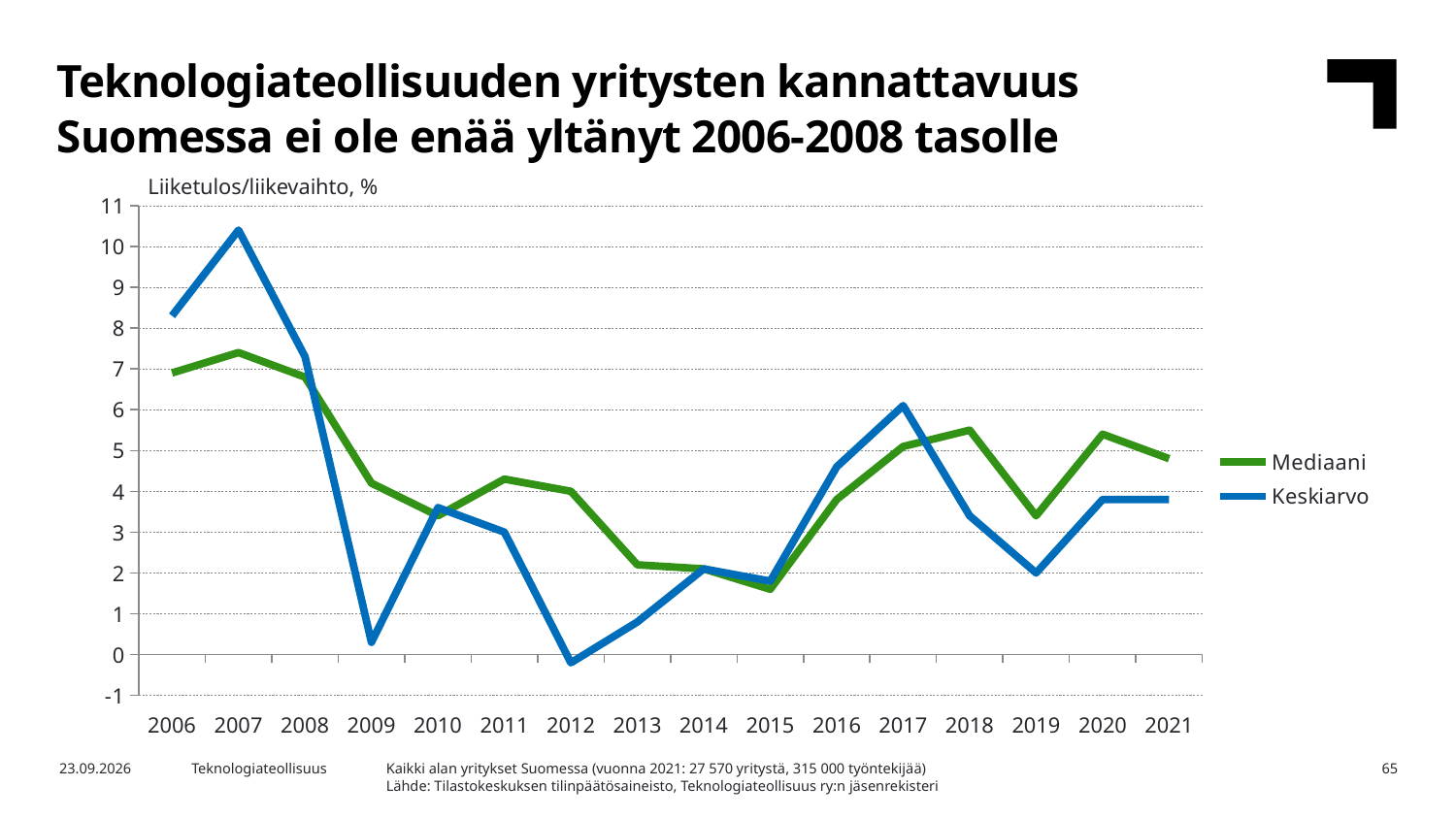
How many years are shown on the x axis? 16 In which year does the Keskiarvo series reach its highest value? 2007 Does the Keskiarvo series rise or fall from 2007 to 2009? fall What kind of chart is shown on the slide? line chart What is the label shown above the y axis of the chart? Liiketulos/liikevaihto, % How many series does the legend list? 2 In which year does the Mediaani series reach its lowest value? 2015 Is the Keskiarvo value for 2009 greater or less than 1? less In which year does the Keskiarvo series reach its lowest value? 2012 Is the Mediaani value for 2020 greater or less than 5? greater Is the Mediaani value for 2006 greater or less than 6? greater In 2012, which series has the larger value, Mediaani or Keskiarvo? Mediaani